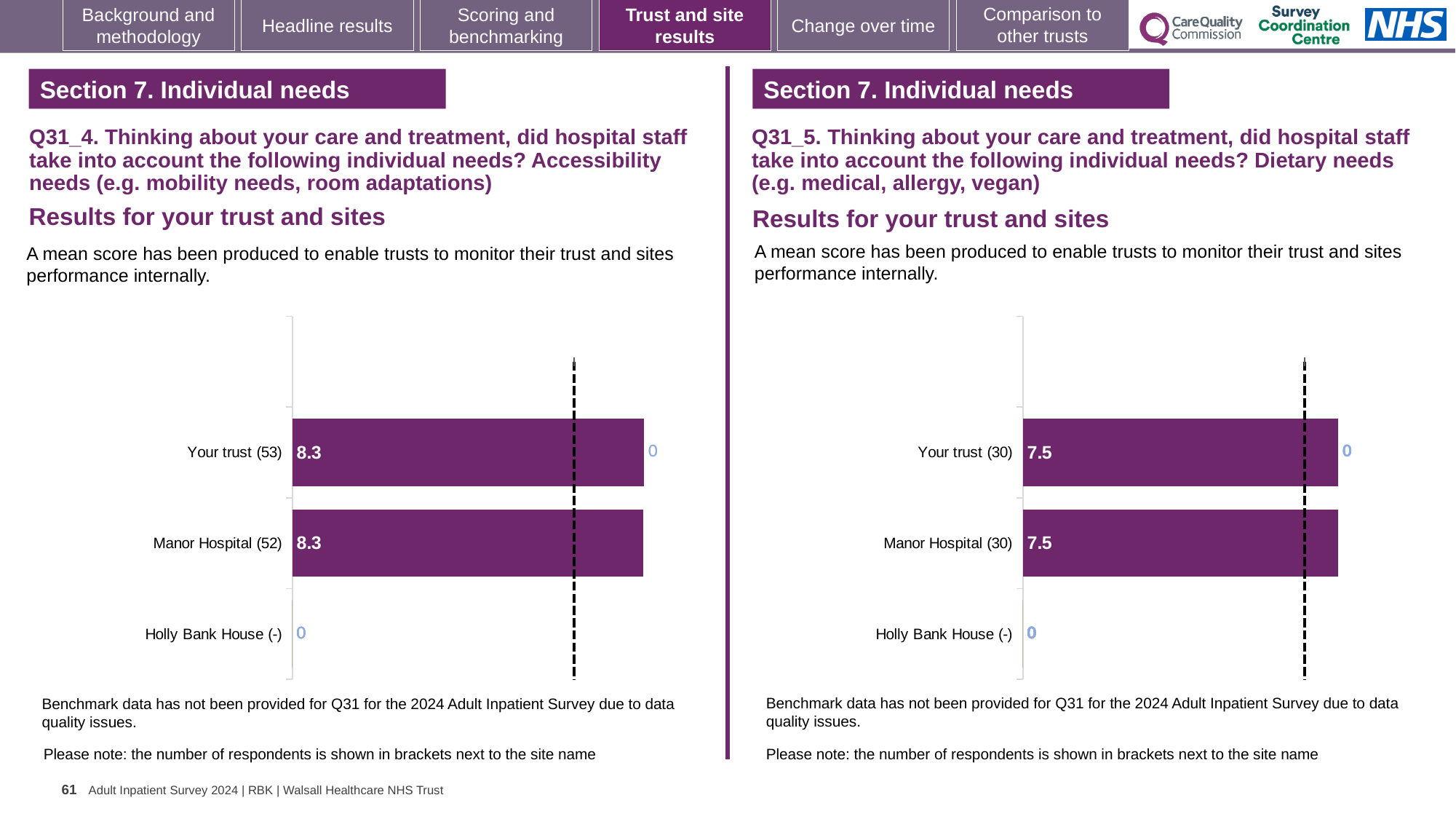
On the Q31_5 chart (right), what is the mean score for Your trust (30)? 7.5 On the Q31_4 chart (left), what is the mean score for Manor Hospital (52)? 8.3 On the Q31_4 chart (left), which category has the lowest value? Holly Bank House (-) On the Q31_4 chart (left), what value is shown for Holly Bank House (-)? 0 How many categories are listed on the Q31_5 chart (right)? 3 On the Q31_5 chart (right), what is the mean score for Manor Hospital (30)? 7.5 On the Q31_4 chart (left), what is the mean score for Your trust (53)? 8.3 On the Q31_5 chart (right), what value is shown for Holly Bank House (-)? 0 On the Q31_4 chart (left), how many respondents are shown in brackets for Manor Hospital? 52 How many categories are listed on the Q31_4 chart (left)? 3 On the Q31_5 chart (right), which category has the lowest value? Holly Bank House (-) What kind of chart is the Q31_4 chart on the left? Bar chart